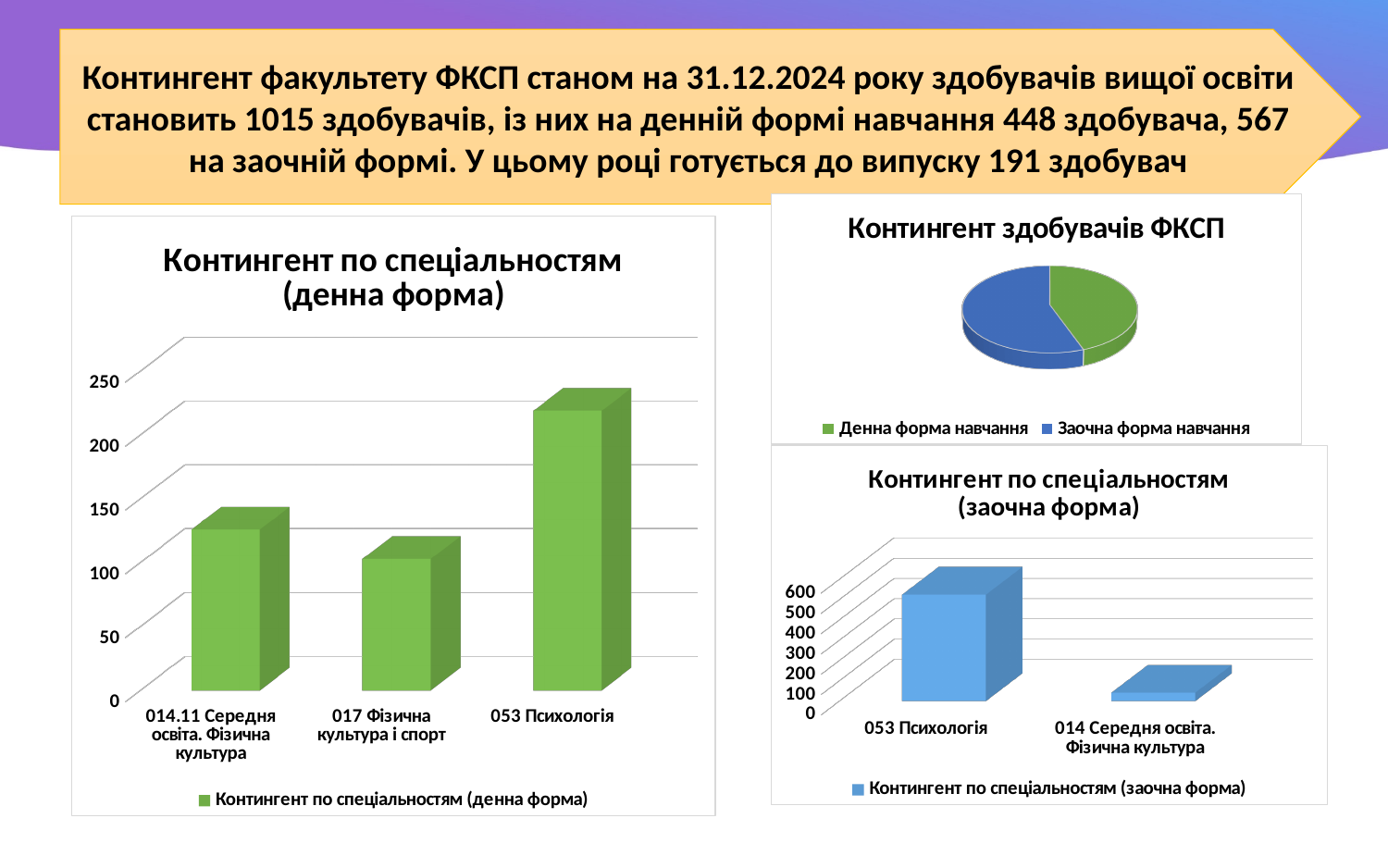
In the chart "Контингент по спеціальностям (денна форма)", is the value for 017 Фізична культура і спорт greater or less than 150? less In the chart "Контингент по спеціальностям (заочна форма)", which category has the lowest value? 014 Середня освіта. Фізична культура How many categories are shown in the chart "Контингент по спеціальностям (денна форма)"? 3 What kind of chart is "Контингент здобувачів ФКСП"? pie chart In the chart "Контингент здобувачів ФКСП", which slice is larger: Денна форма навчання or Заочна форма навчання? Заочна форма навчання In the chart "Контингент по спеціальностям (заочна форма)", is the value for 053 Психологія greater or less than 400? greater In the chart "Контингент по спеціальностям (денна форма)", is the value for 053 Психологія greater or less than 200? greater How many entries does the legend of the chart "Контингент здобувачів ФКСП" list? 2 What kind of chart is "Контингент по спеціальностям (денна форма)"? bar chart How many categories are shown in the chart "Контингент по спеціальностям (заочна форма)"? 2 In the chart "Контингент по спеціальностям (денна форма)", which category has the highest value? 053 Психологія In the chart "Контингент по спеціальностям (денна форма)", which category has the lowest value? 017 Фізична культура і спорт